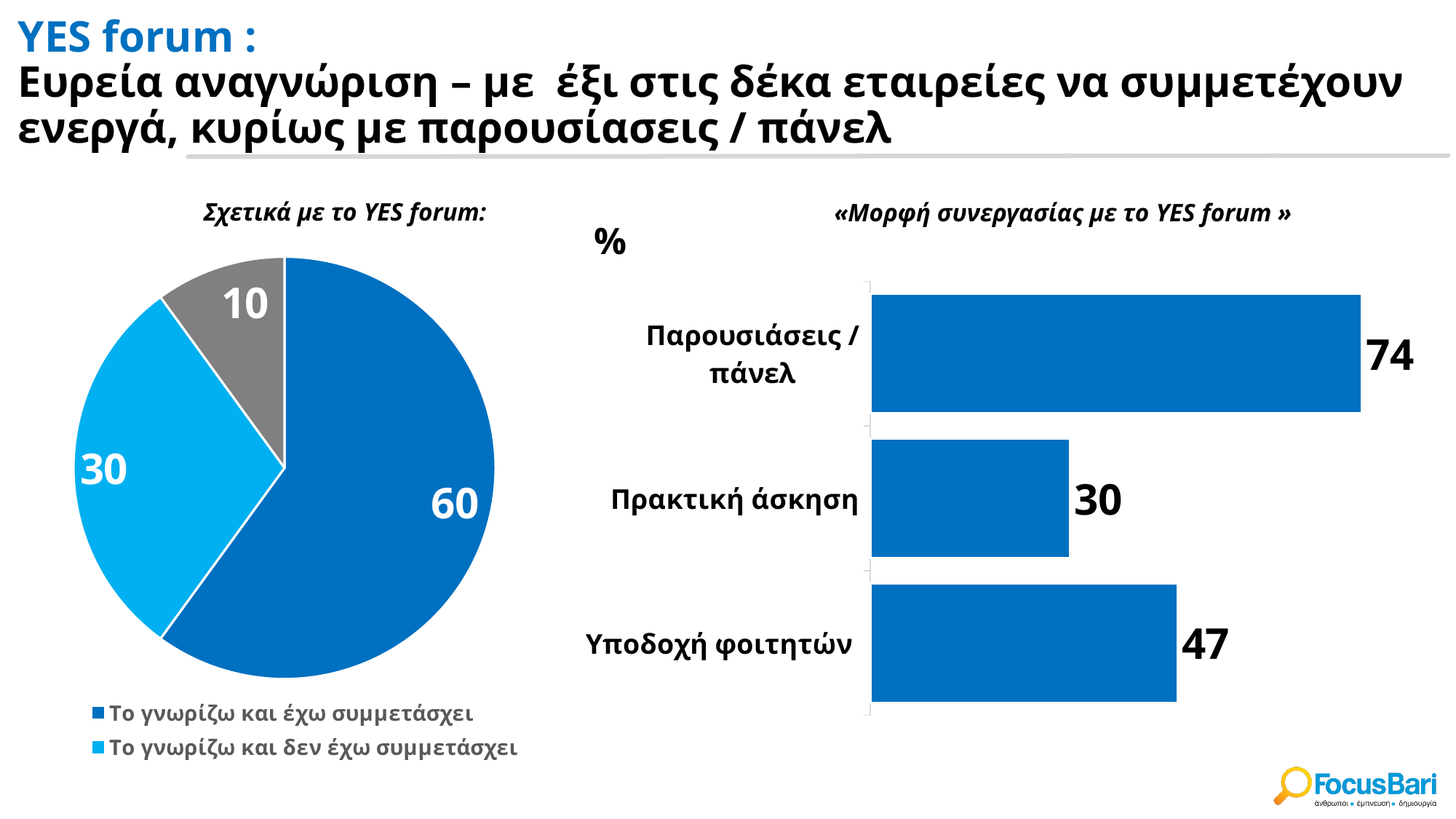
In the pie chart 'Σχετικά με το YES forum:', which slice is the largest? Το γνωρίζω και έχω συμμετάσχει In the pie chart 'Σχετικά με το YES forum:', how many entries does the legend list? 2 In the pie chart 'Σχετικά με το YES forum:', what value is shown for 'Το γνωρίζω και έχω συμμετάσχει'? 60 In the pie chart 'Σχετικά με το YES forum:', what value is shown for 'Το γνωρίζω και δεν έχω συμμετάσχει'? 30 In the chart '«Μορφή συνεργασίας με το YES forum »', which category has the lowest value? Πρακτική άσκηση In the chart '«Μορφή συνεργασίας με το YES forum »', what is the difference between 'Παρουσιάσεις / πάνελ' and 'Υποδοχή φοιτητών'? 27 In the pie chart 'Σχετικά με το YES forum:', what value is shown on the grey slice? 10 In the chart '«Μορφή συνεργασίας με το YES forum »', which is larger: 'Πρακτική άσκηση' or 'Υποδοχή φοιτητών'? Υποδοχή φοιτητών In the chart '«Μορφή συνεργασίας με το YES forum »', what is the value for 'Παρουσιάσεις / πάνελ'? 74 In the pie chart 'Σχετικά με το YES forum:', how many slices are there? 3 What kind of chart is '«Μορφή συνεργασίας με το YES forum »'? Bar chart In the chart '«Μορφή συνεργασίας με το YES forum »', what is the value for 'Υποδοχή φοιτητών'? 47